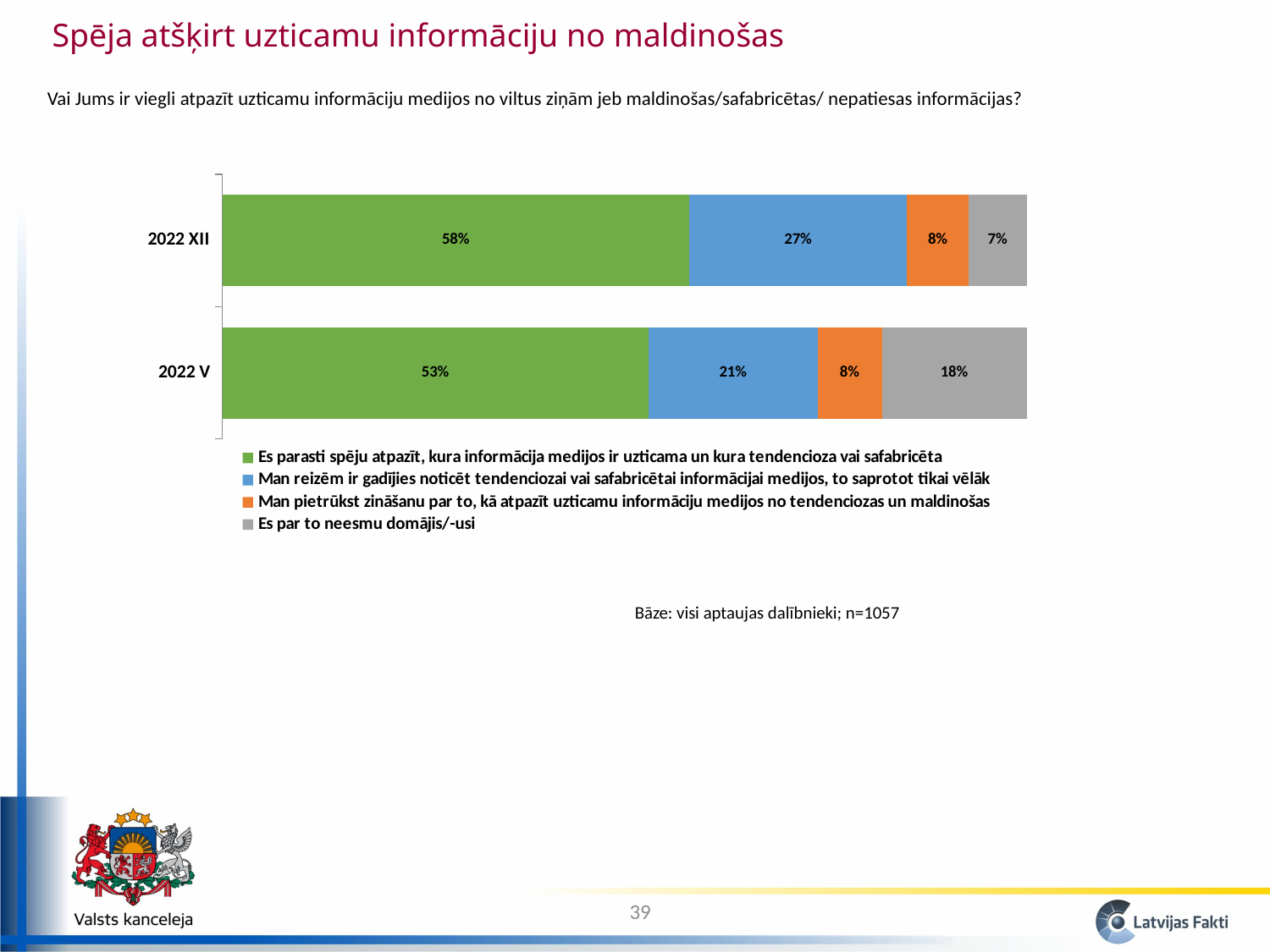
By how many percentage points did the grey segment ('Es par to neesmu domājis/-usi') change from 2022 V to 2022 XII? 11 percentage points lower Which segment is the largest in the 2022 V bar? Es parasti spēju atpazīt, kura informācija medijos ir uzticama un kura tendencioza vai safabricēta (53%) What is the value of the grey segment ('Es par to neesmu domājis/-usi') for 2022 V? 18% How many series does the legend list? 4 What is the value of the blue segment for 2022 V? 21% What percentage of respondents in 2022 XII said they can usually recognise which information in the media is trustworthy (green segment)? 58% What is the value of the orange segment ('Man pietrūkst zināšanu...') for 2022 XII? 8% Which segment is the smallest in the 2022 XII bar? Es par to neesmu domājis/-usi (7%) Which period has the larger green segment, 2022 XII or 2022 V? 2022 XII What is the difference between the blue segment values for 2022 XII and 2022 V? 6 percentage points How many bars (periods) are shown in the chart? 2 What type of chart is shown on the slide? Stacked horizontal bar chart